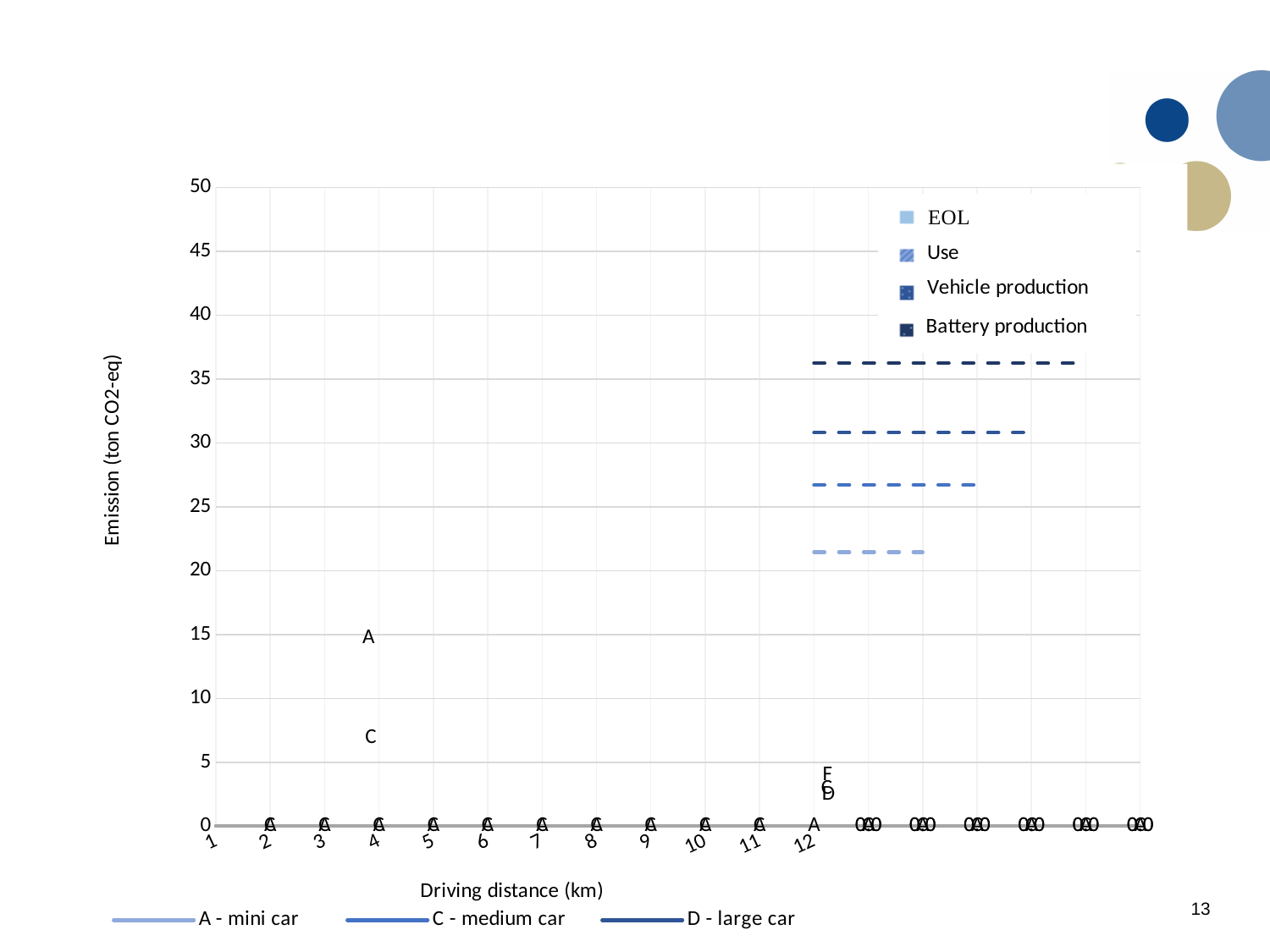
Is the value of the lowest dashed line greater or less than 25? less What is the highest value shown on the y axis? 50 What is the title of the x axis? Driving distance (km) Is the value of the lowest dashed line greater or less than 20? greater Is the value of the topmost dashed line greater or less than 35? greater What is the title of the y axis? Emission (ton CO2-eq) How many series does the legend at the bottom of the chart list? 3 How many entries does the legend inside the plot area (EOL, Use, ...) list? 4 What kind of chart is shown on the slide? line chart